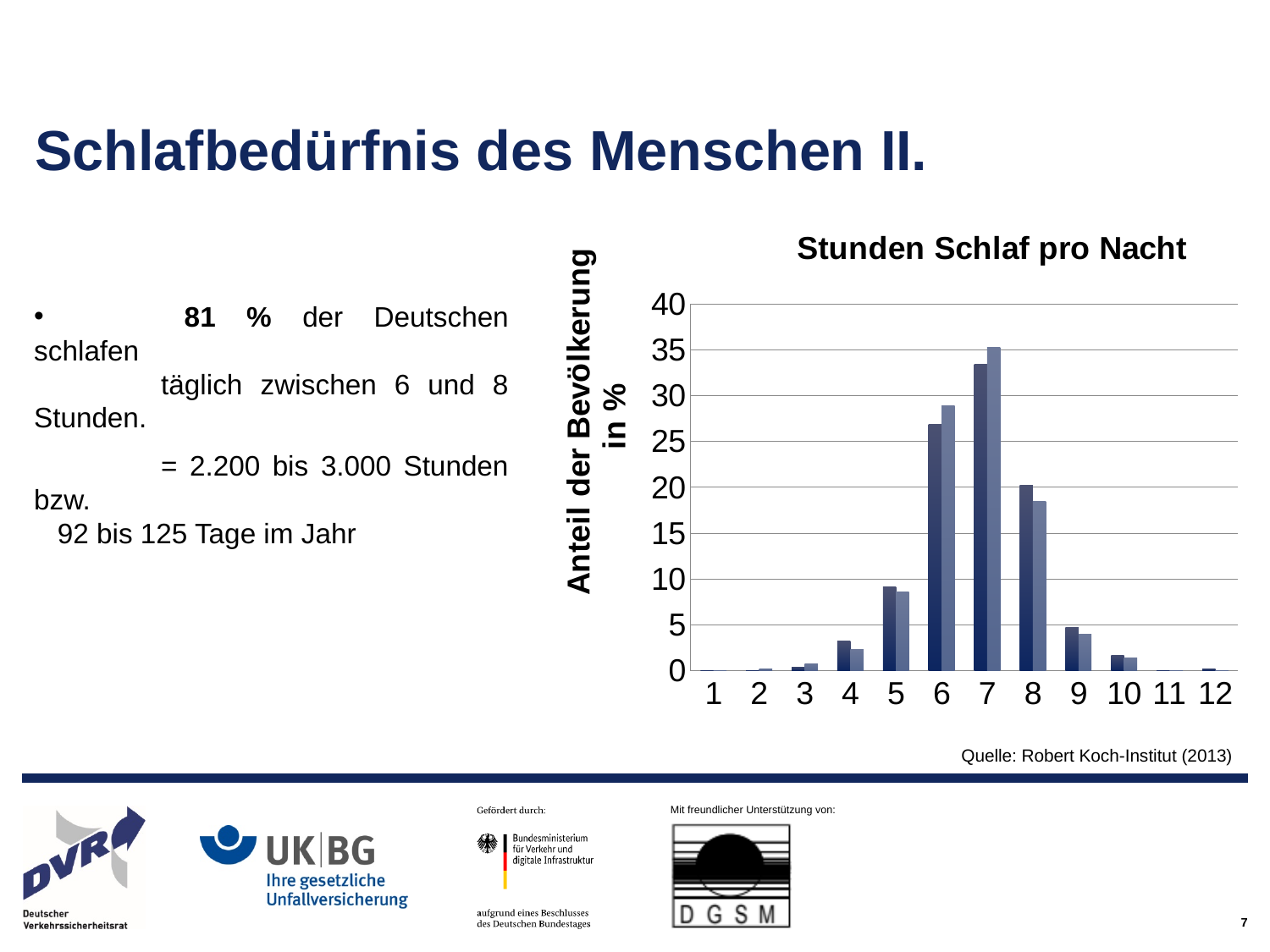
Is the value of the dark blue bar for category 8 greater or less than 25? less Which category on the x axis has the highest bars? 7 What is the label of the vertical axis of the chart? Anteil der Bevölkerung in % Is the value of the dark blue bar for category 5 greater or less than 10? less How many categories are shown on the x axis of the chart? 12 Which has the larger dark blue bar, category 5 or category 9? 5 Do the values rise or fall along the x axis from category 7 to category 12? fall What type of chart is shown on the slide? bar chart Is the value of the dark blue bar for category 7 greater or less than 30? greater What is the title of the chart? Stunden Schlaf pro Nacht Which has the larger dark blue bar, category 6 or category 8? 6